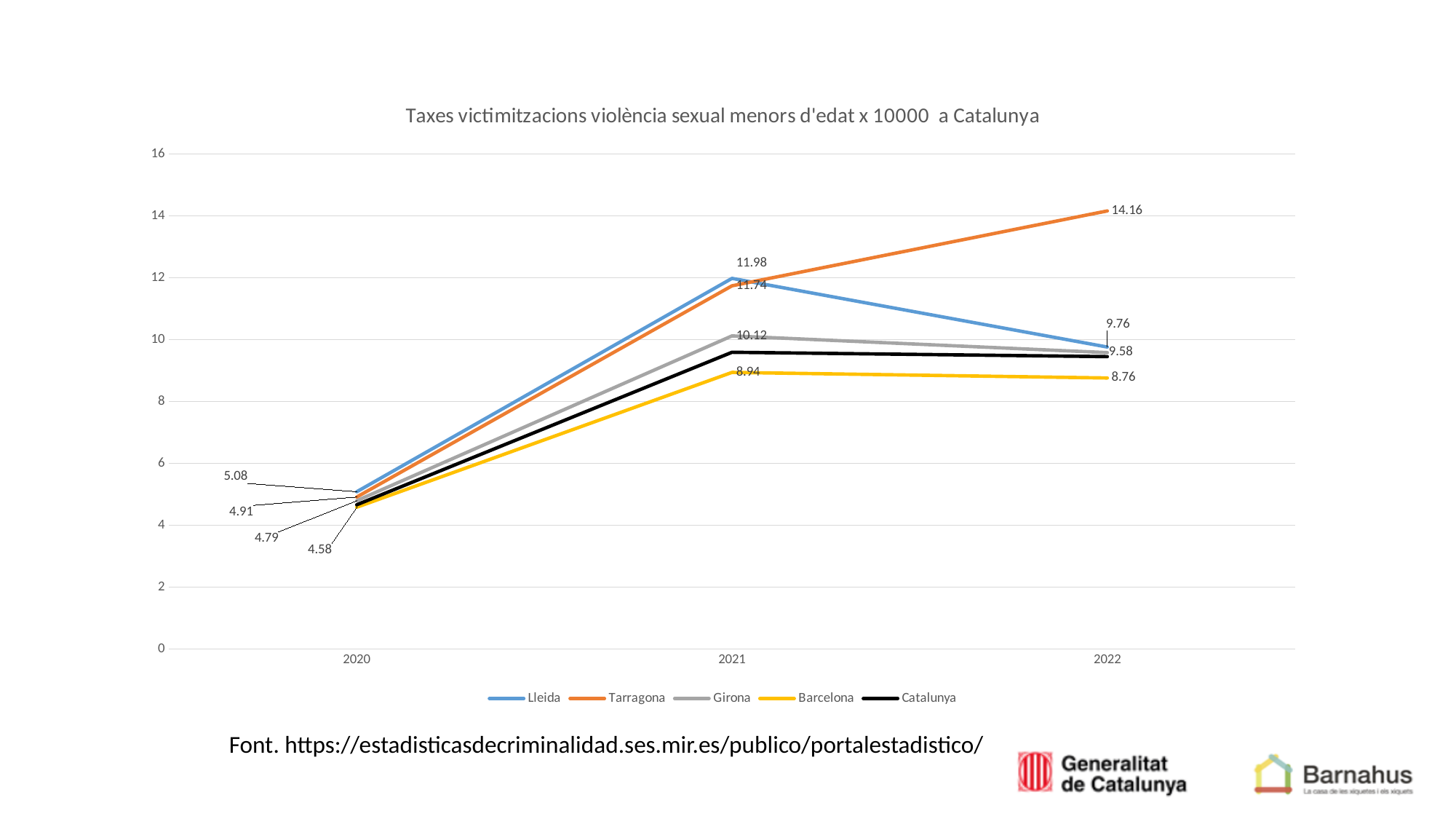
Which series has the lowest value in 2022? Barcelona Which is larger in 2021, the value for Girona or the value for Barcelona? Girona What is the value for Barcelona in 2021? 8.94 What is the value for Lleida in 2021? 11.98 How many series does the legend list? 5 What is the difference between the Tarragona and Lleida values in 2022? 4.40 Which series has the highest value in 2022? Tarragona What is the value for Girona in 2022? 9.58 Does the Tarragona series rise or fall from 2020 to 2022? Rise Is the value for Catalunya in 2022 greater or less than 10? less What kind of chart is shown on the slide? Line chart What is the value for Tarragona in 2022? 14.16